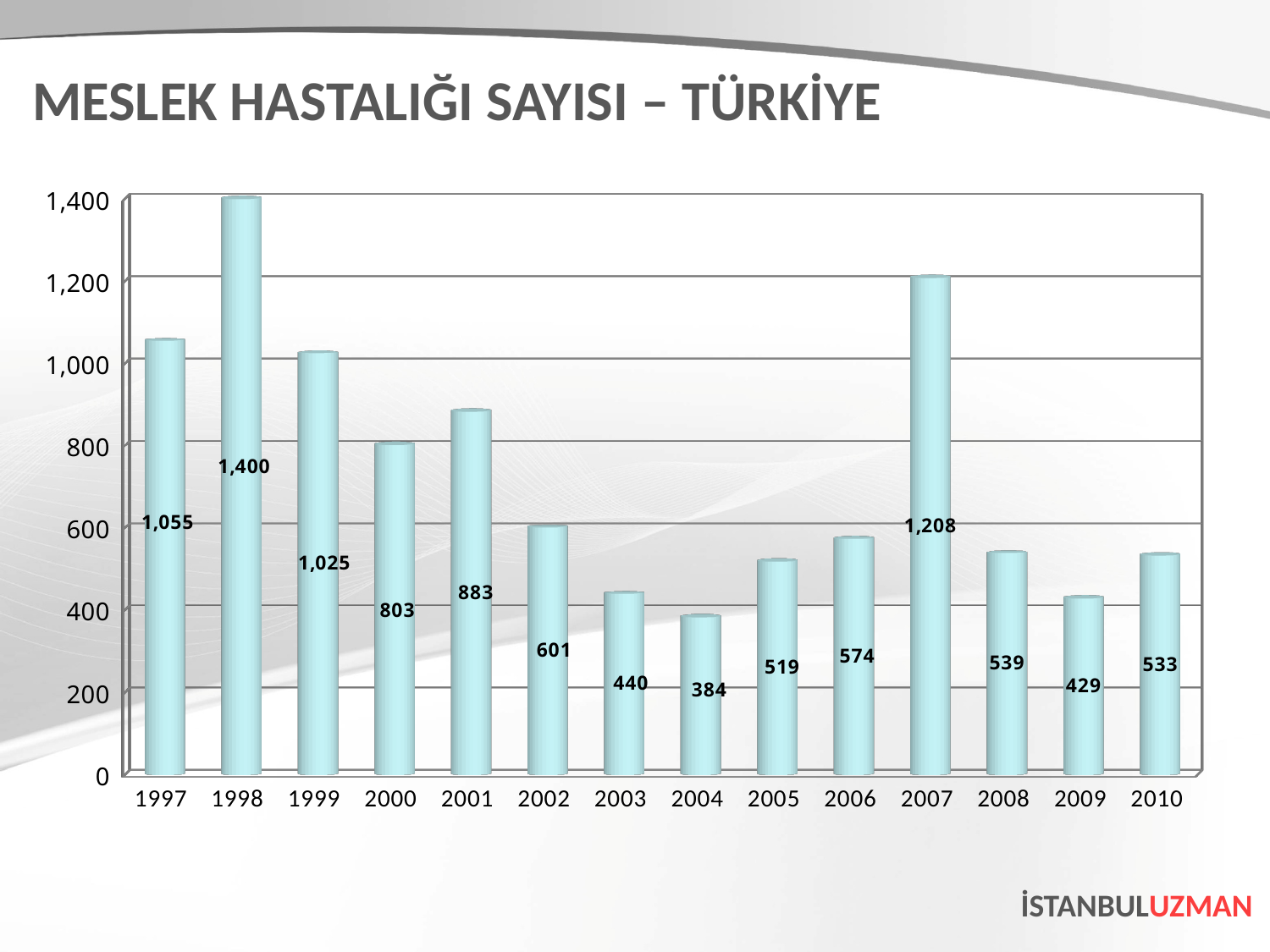
What kind of chart is shown on the slide? bar chart Which is larger, the value for 2005 or the value for 2006? 2006 What is the value for 2004? 384 Which year has the highest value? 1998 What is the value for 2007? 1,208 Which year has the lowest value? 2004 How many years are shown on the x axis? 14 Is the value for 2001 greater or less than 800? greater What is the value for 1998? 1,400 What is the difference between the values for 1997 and 1999? 30 What is the difference between the values for 1998 and 2007? 192 What is the title of the slide? MESLEK HASTALIĞI SAYISI – TÜRKİYE